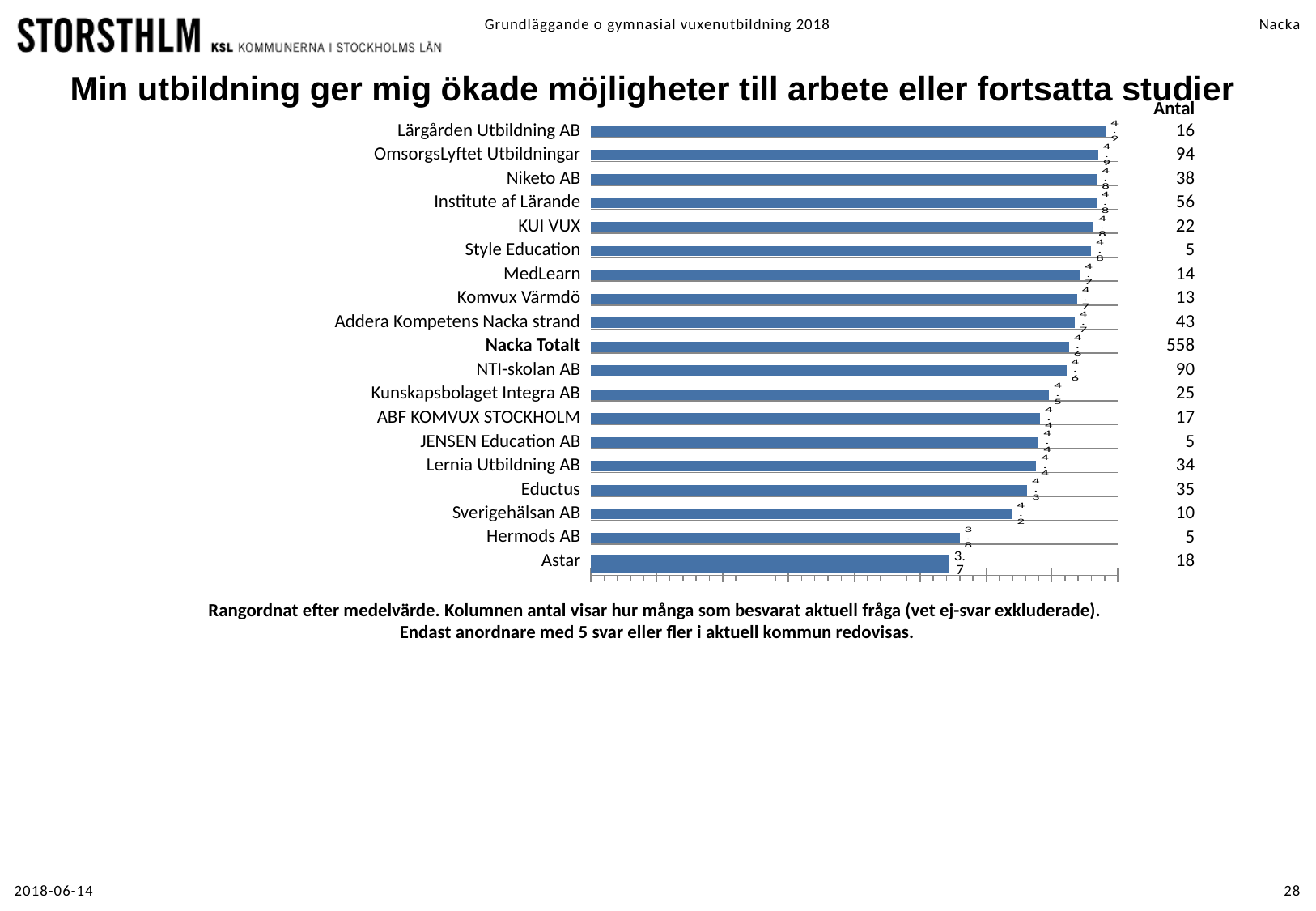
What is the value shown for Astar? 3.7 What is the value shown for Kunskapsbolaget Integra AB? 4.5 What is the difference between the values for Nacka Totalt and Hermods AB? 0.8 What is the difference between the values for Lärgården Utbildning AB and Astar? 1.2 What is the value shown for Nacka Totalt? 4.6 What is the value shown for Sverigehälsan AB? 4.2 Do the bar values increase or decrease going from the top of the chart to the bottom? Decrease What is the value shown for Hermods AB? 3.8 Which has a larger value, Eductus or Hermods AB? Eductus Which category has the lowest value in the chart? Astar What kind of chart is shown on the slide? Bar chart How many categories are shown in the chart? 19